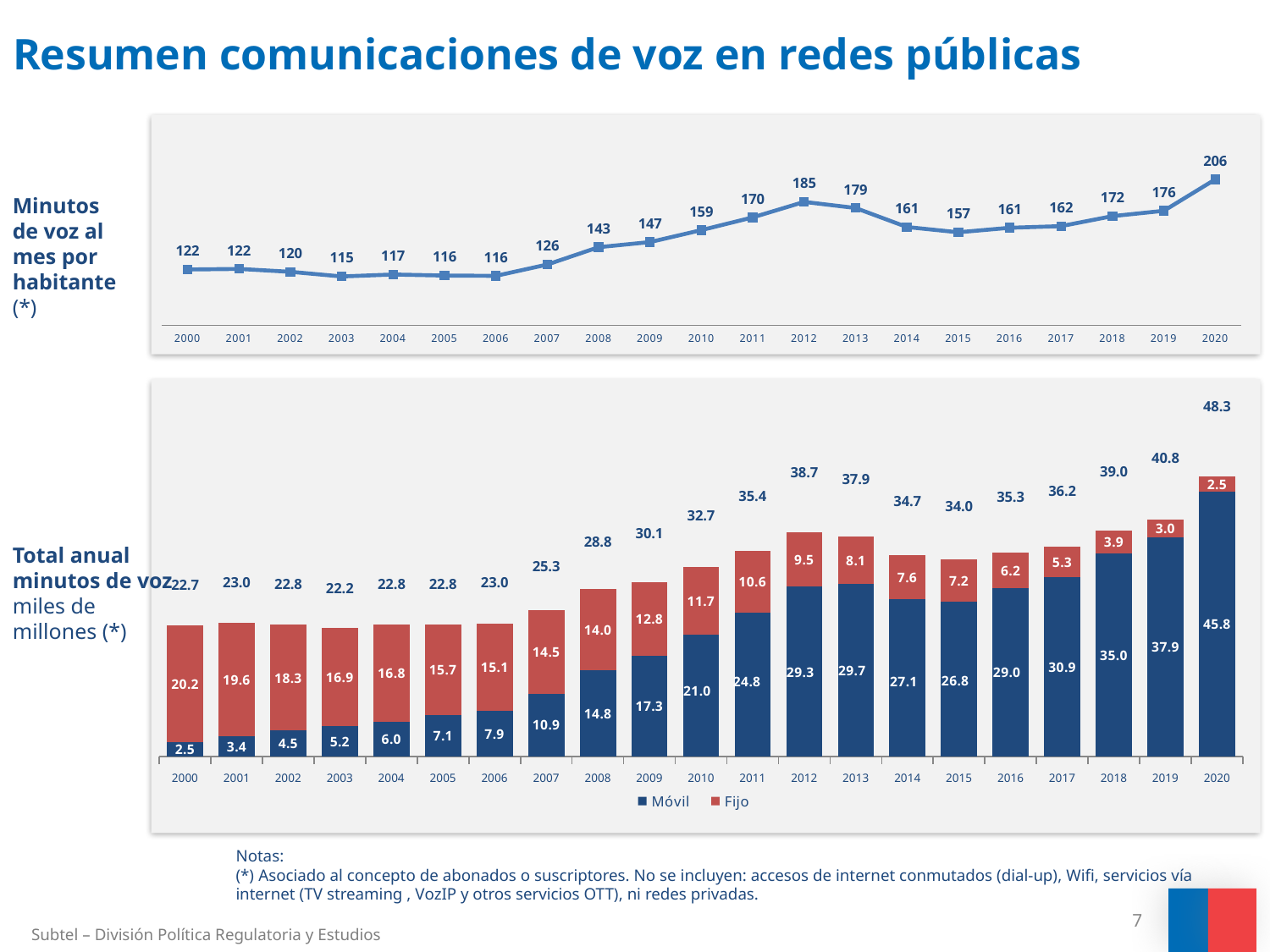
In the bottom chart (Total anual minutos de voz), what is the Móvil value for 2010? 21.0 How many years are shown on the x axis of the bottom chart (Total anual minutos de voz)? 21 In the top chart (Minutos de voz al mes por habitante), which year has the highest value? 2020 In the top chart (Minutos de voz al mes por habitante), what is the value for 2012? 185 In the bottom chart (Total anual minutos de voz), what is the total for 2020? 48.3 In the bottom chart (Total anual minutos de voz), what is the Fijo value for 2000? 20.2 In the bottom chart (Total anual minutos de voz), which year has the highest Fijo value? 2000 In the top chart (Minutos de voz al mes por habitante), what is the difference between the 2020 value and the 2000 value? 84 In the top chart (Minutos de voz al mes por habitante), which year has the lowest value? 2003 How many series does the legend of the bottom chart (Total anual minutos de voz) list? 2 What type of chart is the top chart (Minutos de voz al mes por habitante)? Line chart In the bottom chart (Total anual minutos de voz), is the Móvil value for 2005 larger or the Fijo value for 2005? Fijo